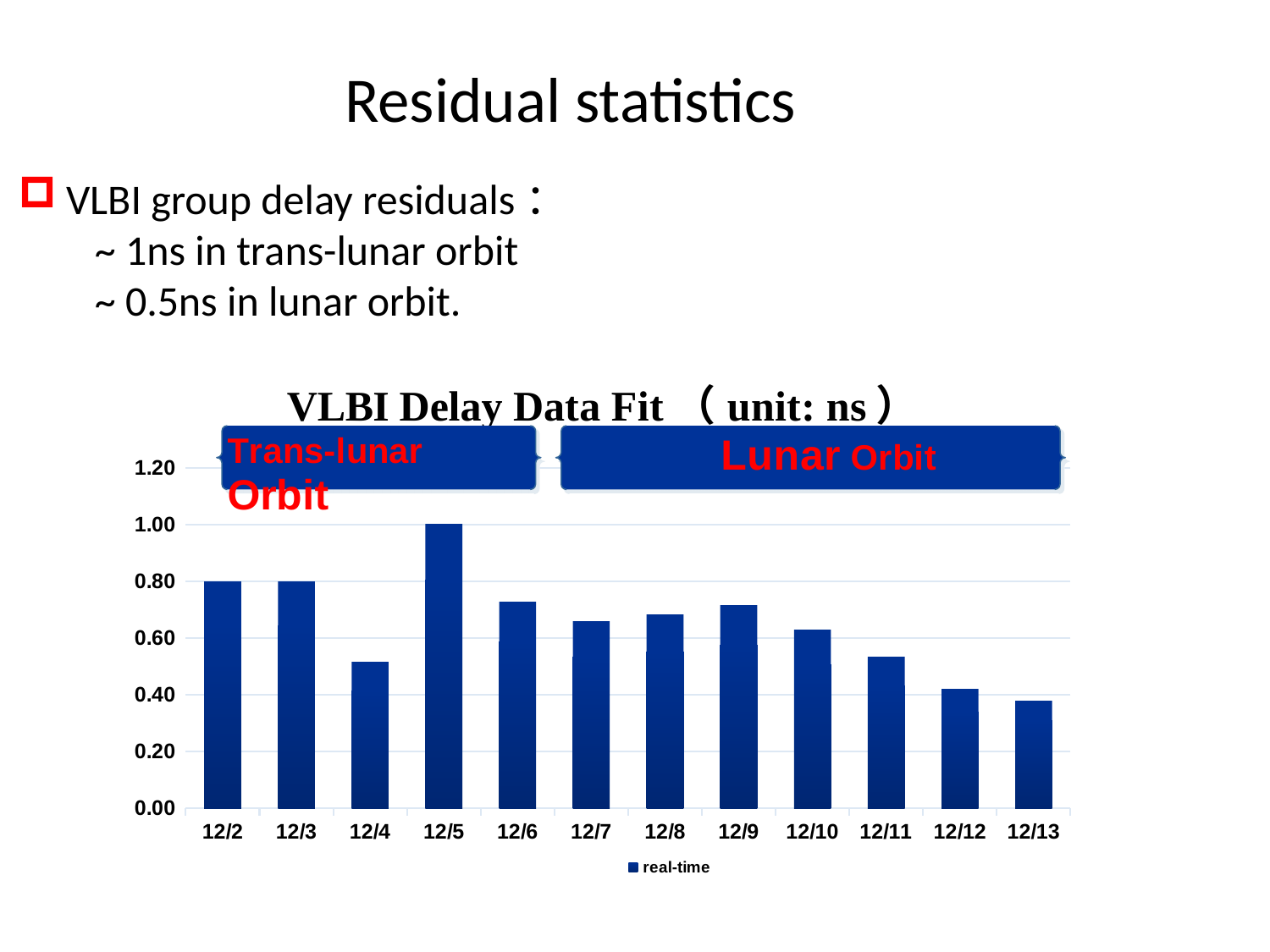
Do the values rise or fall from 12/9 to 12/13? fall What is the name of the series shown in the chart legend? real-time Which date has the lowest value in the chart? 12/13 What type of chart is shown on the slide? bar chart Which is larger, the value for 12/4 or the value for 12/6? 12/6 Is the value for 12/4 greater or less than 0.60? less What unit is given in the chart title? ns Is the value for 12/6 greater or less than 0.60? greater How many series does the chart legend list? 1 Which date has the highest value in the chart? 12/5 What is the value for 12/5? 1.00 How many dates are shown on the x axis of the chart? 12